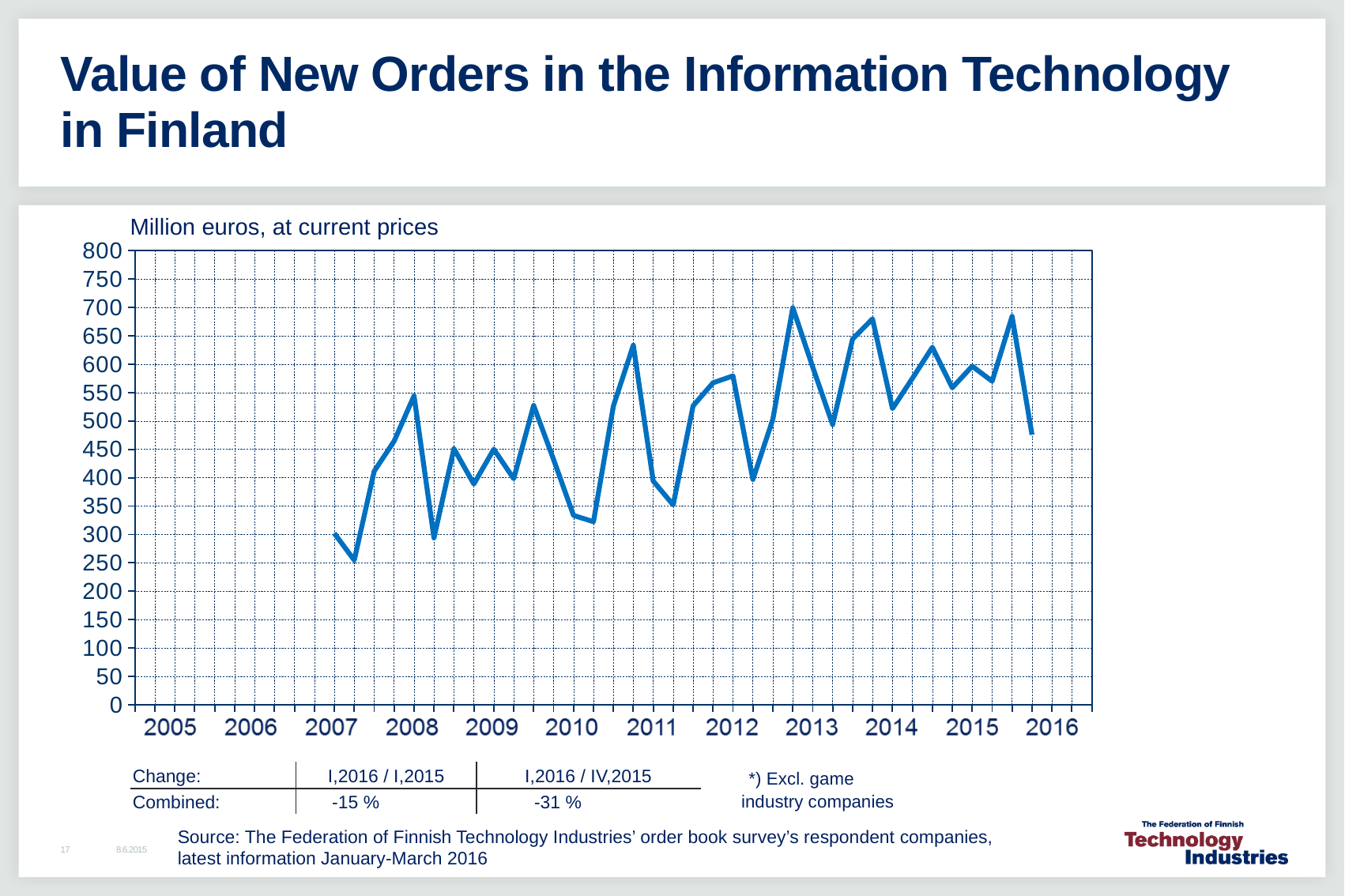
Is the lowest value of the line, in 2007, greater or less than 300? less Is the lowest value of the line in 2011 greater or less than 400? less Is the peak value of the line in late 2015 greater or less than 650? greater How many year labels are shown on the x axis of the chart? 12 Which is larger: the lowest value in 2007 or the lowest value in 2012? the lowest value in 2012 What kind of chart is shown on the slide? line chart In which year does the line reach its lowest value? 2007 What unit is stated above the y axis of the chart? Million euros, at current prices Does the line rise or fall between its late-2015 peak and the 2016 value? fall